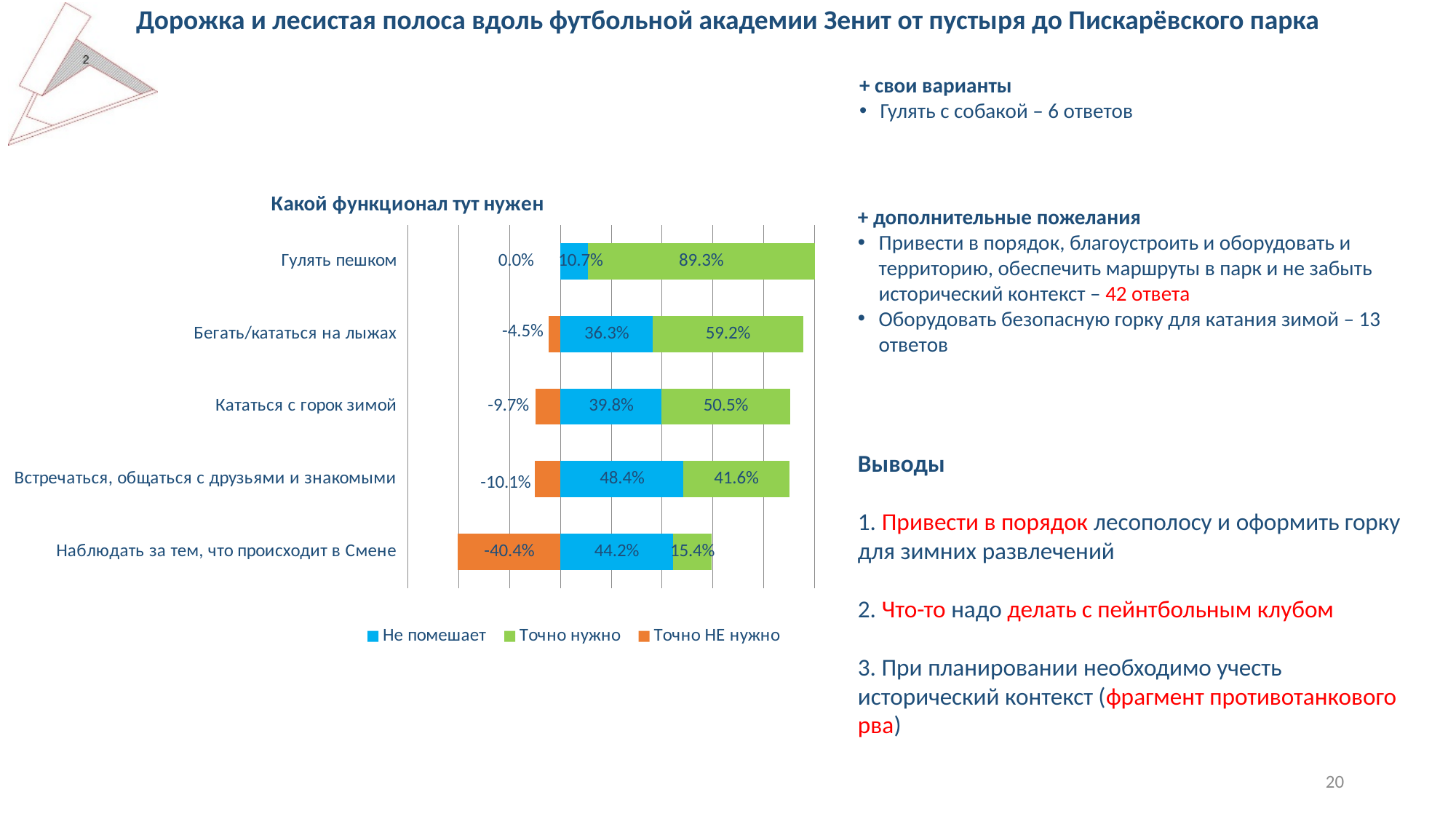
What is the "Точно НЕ нужно" value for "Наблюдать за тем, что происходит в Смене"? -40.4% Which category has the highest "Точно нужно" value? Гулять пешком What is the "Точно нужно" value for "Гулять пешком"? 89.3% What is the "Точно нужно" value for "Кататься с горок зимой"? 50.5% How many categories are plotted in the chart "Какой функционал тут нужен"? 5 How many series does the legend of the chart list? 3 Which is larger for "Встречаться, общаться с друзьями и знакомыми": the "Не помешает" value or the "Точно нужно" value? Не помешает What is the difference between the "Точно нужно" values for "Бегать/кататься на лыжах" and "Кататься с горок зимой"? 8.7% Which series in the legend is shown in orange? Точно НЕ нужно Which category has the lowest "Точно нужно" value? Наблюдать за тем, что происходит в Смене What is the "Не помешает" value for "Бегать/кататься на лыжах"? 36.3% What type of chart is shown under the title "Какой функционал тут нужен"? Stacked bar chart